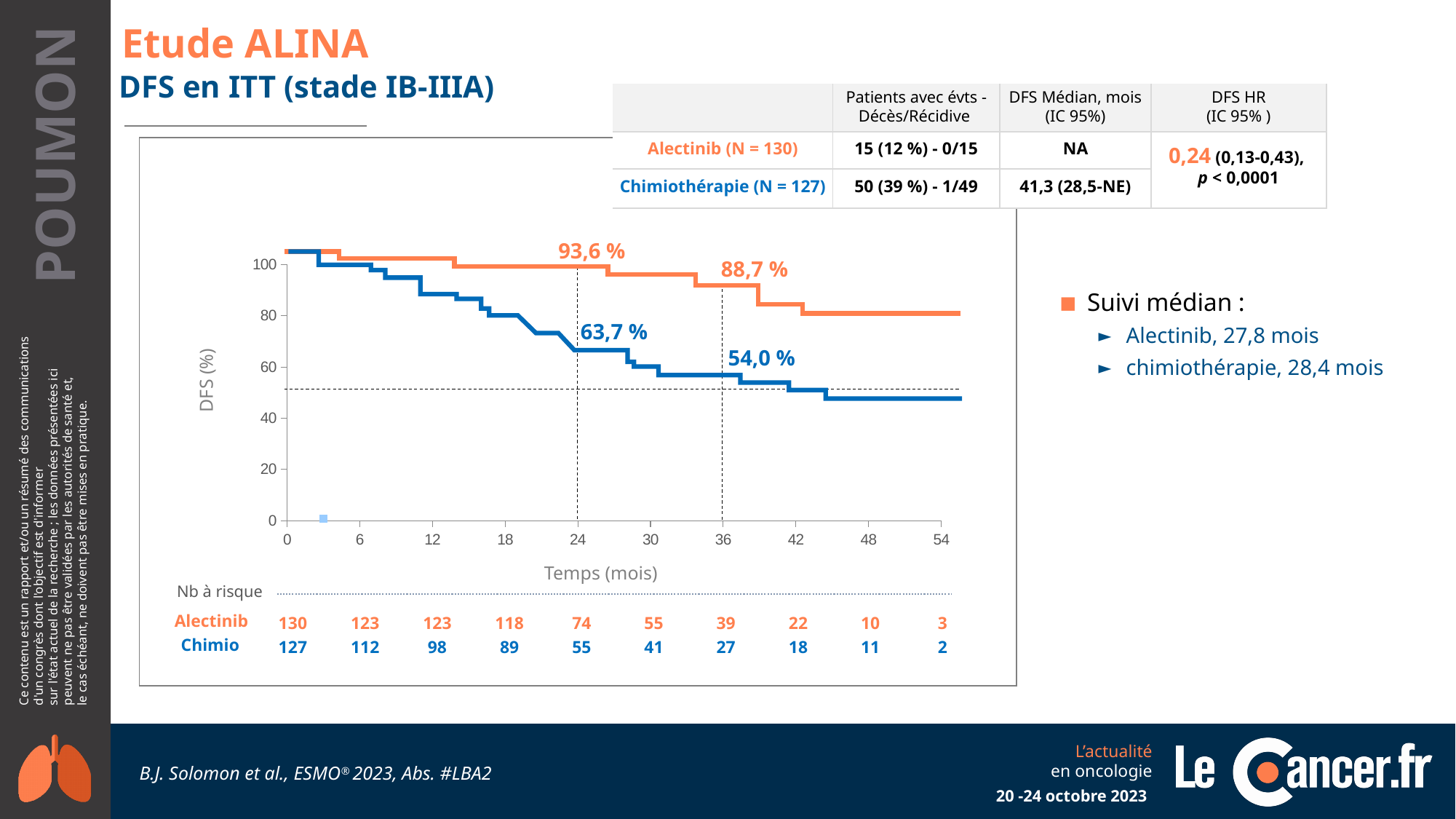
Do the DFS curves rise or fall along the time axis? fall Is the DFS value for the chemotherapy curve at 48 months greater or less than 60? less What is the DFS rate for the chemotherapy arm at 24 months? 63,7 % What is the DFS rate for the chemotherapy arm at 36 months? 54,0 % What is the DFS rate for Alectinib at 36 months? 88,7 % How many patients were at risk in the Chimio arm at 12 months? 98 What is the DFS rate for Alectinib at 24 months? 93,6 % How many patients were at risk in the Alectinib arm at 24 months? 74 Which arm has the higher DFS rate at 36 months, Alectinib or chemotherapy? Alectinib What is the label of the y axis of the chart? DFS (%) What is the difference in DFS rate between Alectinib and chemotherapy at 36 months? 34,7 % What is the difference in DFS rate between Alectinib and chemotherapy at 24 months? 29,9 %